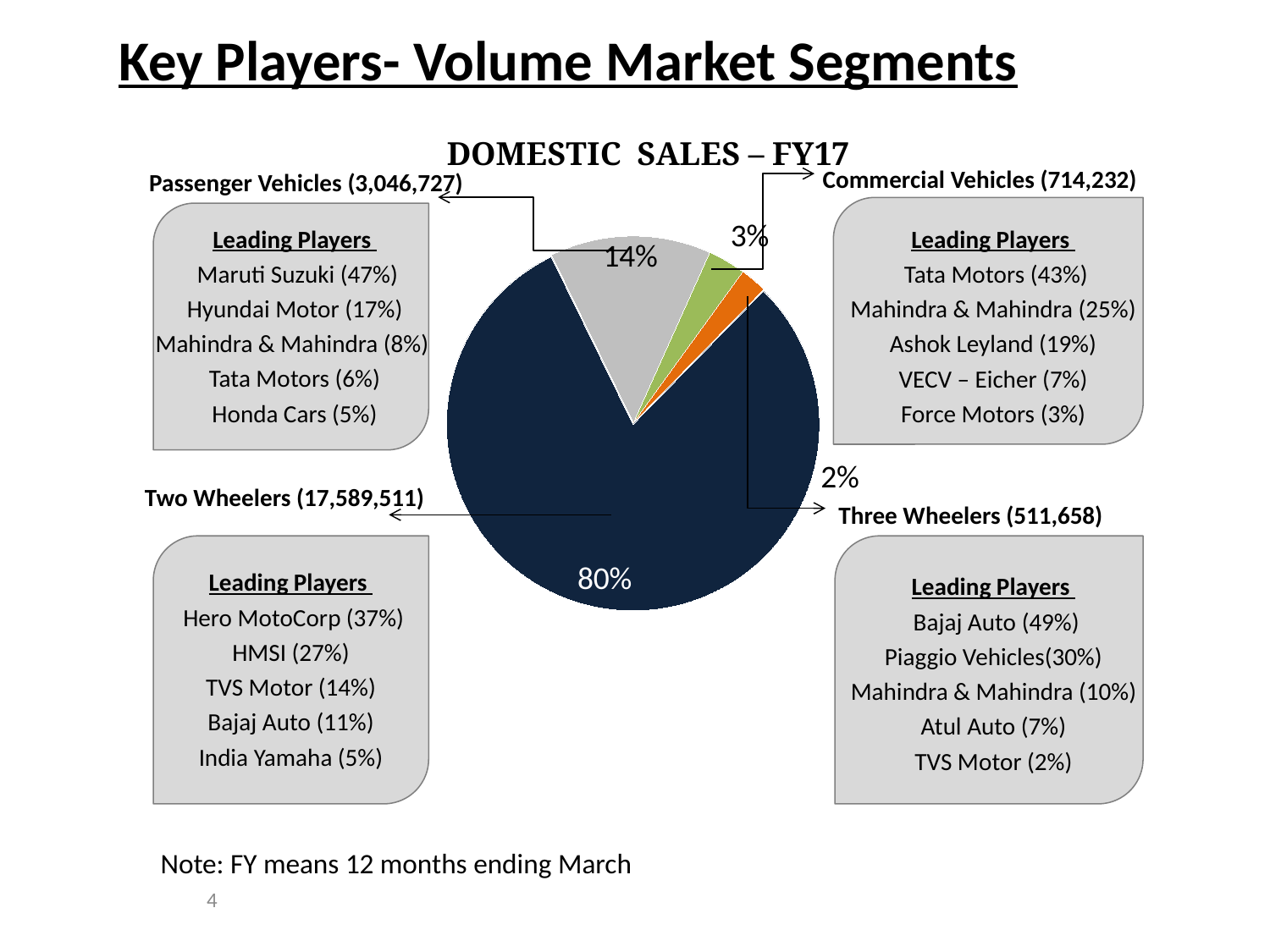
Which segment has the largest share of domestic sales in FY17? Two Wheelers What share of the pie is Passenger Vehicles? 14% What is the sales volume shown for Commercial Vehicles? 714,232 What is the title of the pie chart? DOMESTIC SALES – FY17 What share of domestic sales in FY17 do Two Wheelers account for? 80% How many segments does the pie chart have? 4 What is the sales volume shown for Two Wheelers? 17,589,511 Which segment has the smallest share of domestic sales in FY17? Three Wheelers What share of the pie is Commercial Vehicles? 3% What kind of chart is shown on the slide? Pie chart What is the difference in percentage points between the Two Wheelers share and the Passenger Vehicles share? 66 percentage points